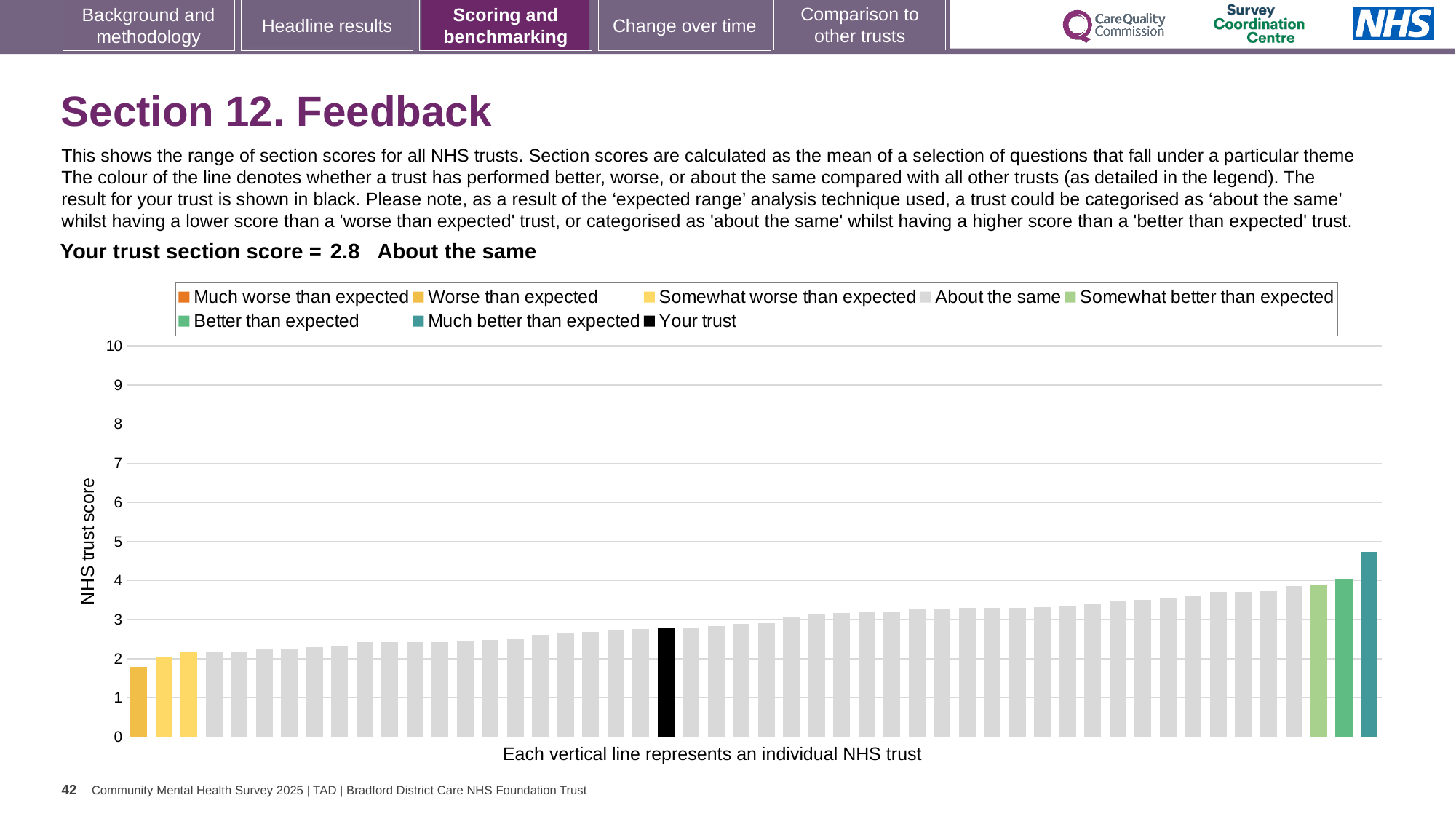
How many entries does the chart legend list? 8 What is the label of the y axis? NHS trust score Do the bar values rise or fall from left to right along the x axis? rise What kind of chart is shown on the slide? bar chart Is the value for your trust (the black bar) greater or less than 3? less What is the maximum value shown on the y axis? 10 Is the value of the shortest bar (the leftmost bar) greater or less than 2? less Is the value of the rightmost bar greater or less than 5? less What category does the black colour in the legend represent? Your trust What is the section score for your trust (the black bar)? 2.8 Which is larger: the value of the rightmost bar or the value of the black 'Your trust' bar? the rightmost bar